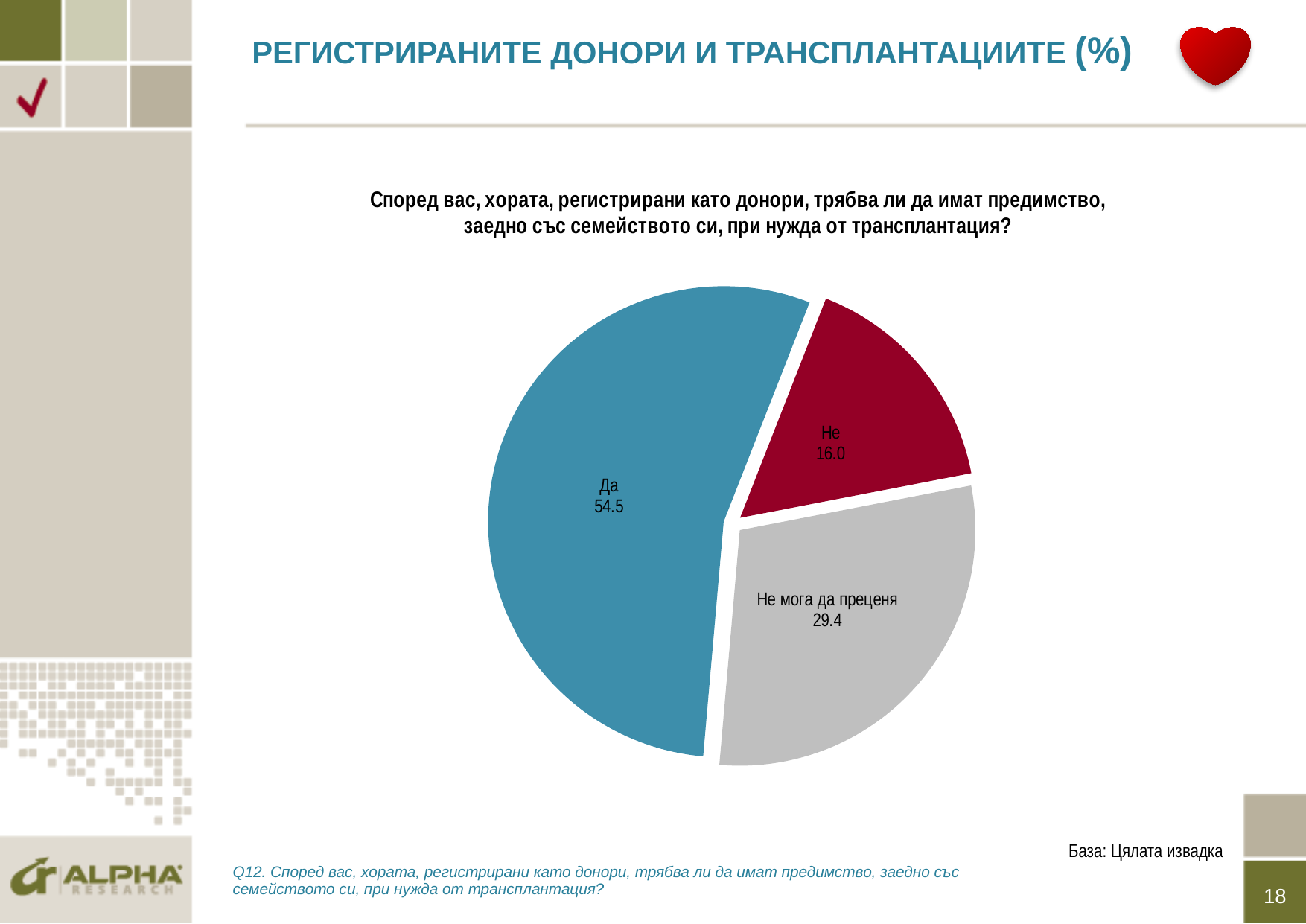
How many slices does the pie chart have? 3 What is the difference between the values for "Не мога да преценя" and "Не"? 13.4 Which slice of the pie is the smallest? Не What is the difference between the values for "Да" and "Не"? 38.5 What is the value for "Да"? 54.5 What is the base noted at the bottom right of the slide? Цялата извадка Which slice of the pie is the largest? Да Which is larger, the value for "Не мога да преценя" or the value for "Не"? Не мога да преценя What kind of chart is shown on the slide? pie chart What is the value for "Не мога да преценя"? 29.4 What is the value for "Не"? 16.0 What colour is the "Да" slice? blue